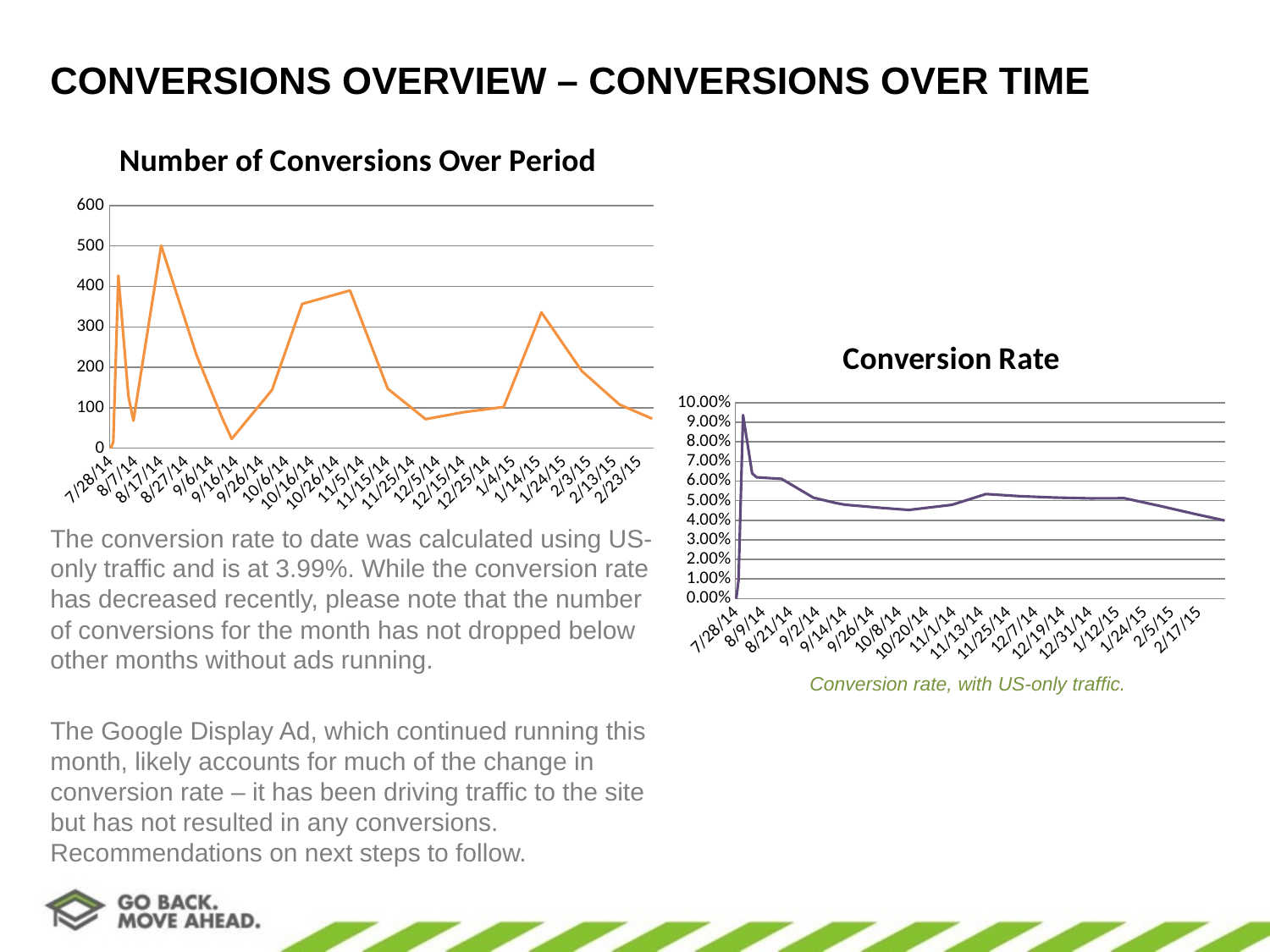
In the 'Conversion Rate' chart, is the peak of the line greater or less than 8.00%? greater What kind of chart is the 'Number of Conversions Over Period' chart? Line chart In the 'Number of Conversions Over Period' chart, is the value for 9/16/14 greater or less than 100? less In the 'Number of Conversions Over Period' chart, is the value for 8/17/14 greater or less than 400? greater In the 'Number of Conversions Over Period' chart, on which date does the line reach its highest point? 8/17/14 What kind of chart is the 'Conversion Rate' chart? Line chart In the 'Conversion Rate' chart, does the line rise or fall from 12/31/14 to 2/17/15? Fall In the 'Number of Conversions Over Period' chart, which is larger, the value for 8/17/14 or the value for 1/14/15? 8/17/14 What is the caption printed below the 'Conversion Rate' chart? Conversion rate, with US-only traffic.